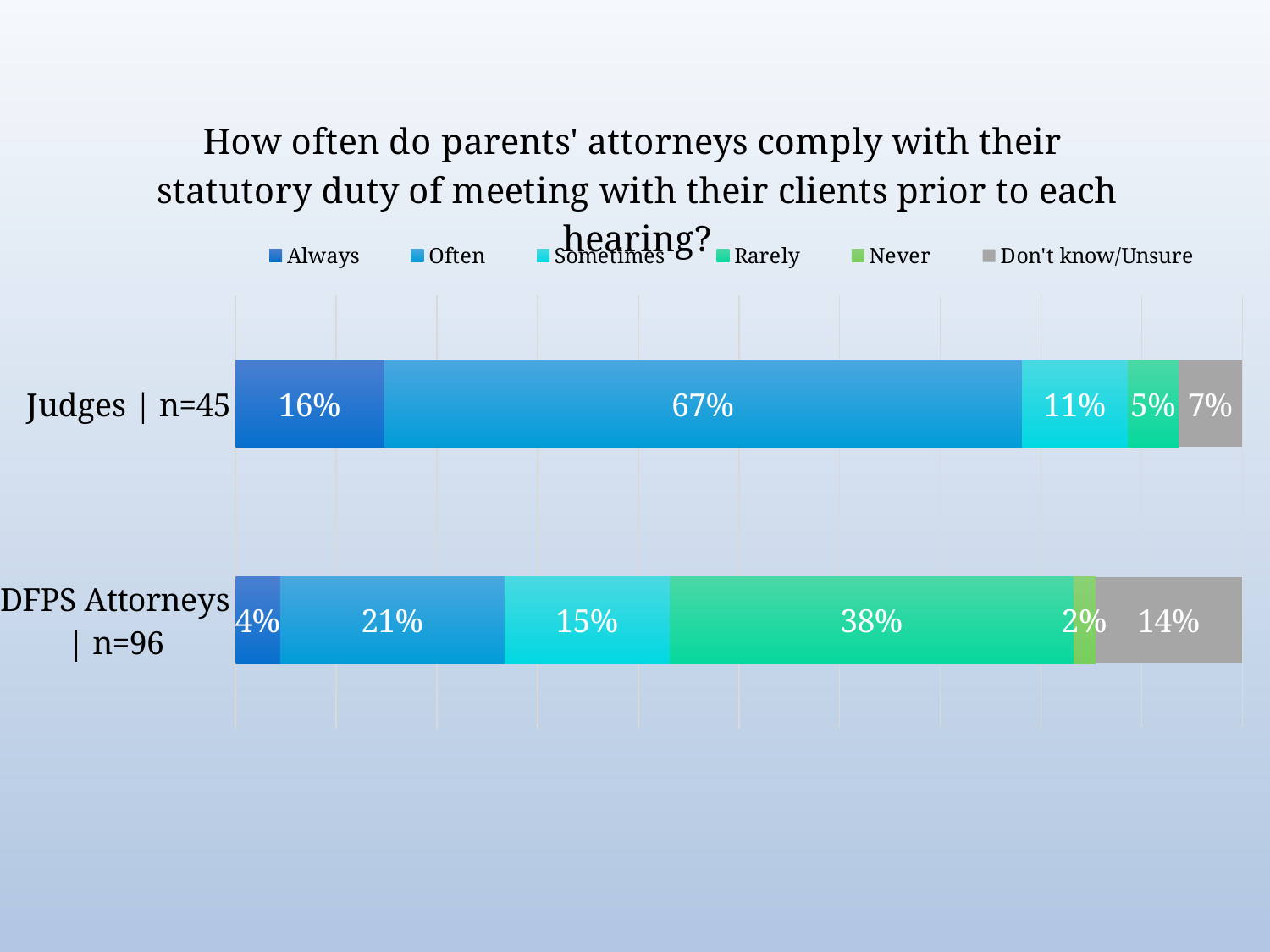
Which group has a larger "Sometimes" share, Judges or DFPS Attorneys? DFPS Attorneys What kind of chart is shown on the slide? Stacked bar chart What percentage of DFPS Attorneys answered "Rarely"? 38% Which response was chosen most often by DFPS Attorneys? Rarely Which response was chosen most often by Judges? Often What is the difference between the "Often" share for Judges and for DFPS Attorneys? 46% What percentage of Judges answered "Always"? 16% What is the sample size (n) shown for the DFPS Attorneys group? 96 What percentage of Judges answered "Often"? 67% How many series does the legend list? 6 How many respondent groups (categories) are plotted? 2 What percentage of DFPS Attorneys answered "Don't know/Unsure"? 14%